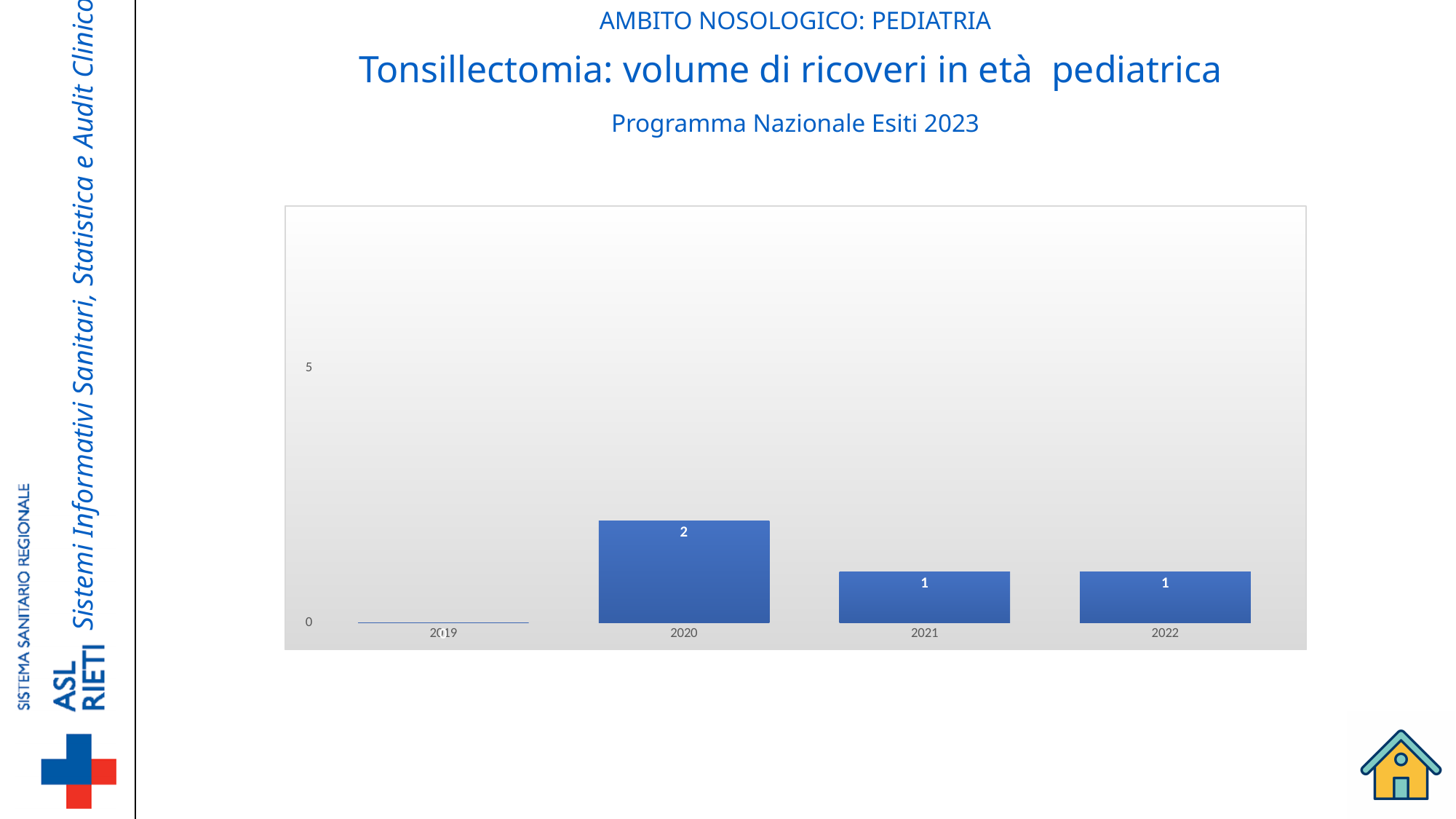
How many years are shown on the x axis? 4 What is the value for 2020? 2 Which year has the highest value? 2020 Do the values rise or fall from 2020 to 2021? fall What kind of chart is shown on the slide? bar chart Which year has the lowest value? 2019 Which is larger, the value for 2020 or the value for 2022? 2020 What is the value for 2021? 1 What is the value for 2019? 0 What is the value for 2022? 1 Is the value for 2020 greater or less than 5? less What is the difference between the values for 2020 and 2021? 1